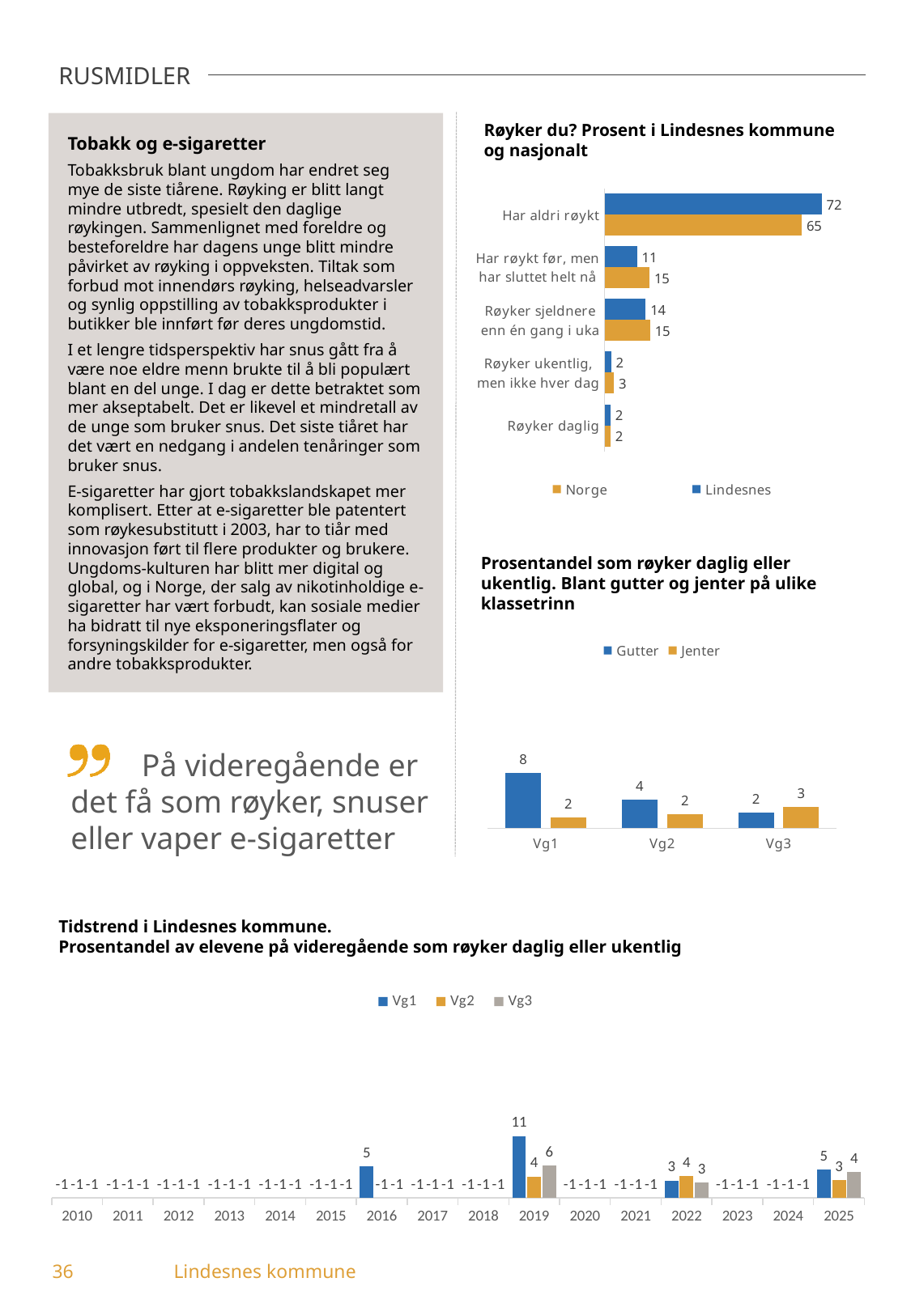
In the chart 'Tidstrend i Lindesnes kommune', how many series does the legend list? 3 In the chart 'Prosentandel som røyker daglig eller ukentlig', which is larger at Vg3, Gutter or Jenter? Jenter What kind of chart is 'Røyker du? Prosent i Lindesnes kommune og nasjonalt'? Bar chart In the chart 'Prosentandel som røyker daglig eller ukentlig', how many class levels are shown on the x axis? 3 In the chart 'Røyker du? Prosent i Lindesnes kommune og nasjonalt', what is the difference between Lindesnes and Norge for 'Har aldri røykt'? 7 In the chart 'Røyker du? Prosent i Lindesnes kommune og nasjonalt', how many series does the legend list? 2 In the chart 'Røyker du? Prosent i Lindesnes kommune og nasjonalt', what is the value for Lindesnes for 'Har aldri røykt'? 72 In the chart 'Røyker du? Prosent i Lindesnes kommune og nasjonalt', what is the value for Norge for 'Har røykt før, men har sluttet helt nå'? 15 In the chart 'Tidstrend i Lindesnes kommune', what is the value for Vg1 in 2019? 11 In the chart 'Prosentandel som røyker daglig eller ukentlig', what is the value for Gutter at Vg1? 8 In the chart 'Røyker du? Prosent i Lindesnes kommune og nasjonalt', which category has the highest value for Lindesnes? Har aldri røykt In the chart 'Tidstrend i Lindesnes kommune', what is the value for Vg3 in 2025? 4